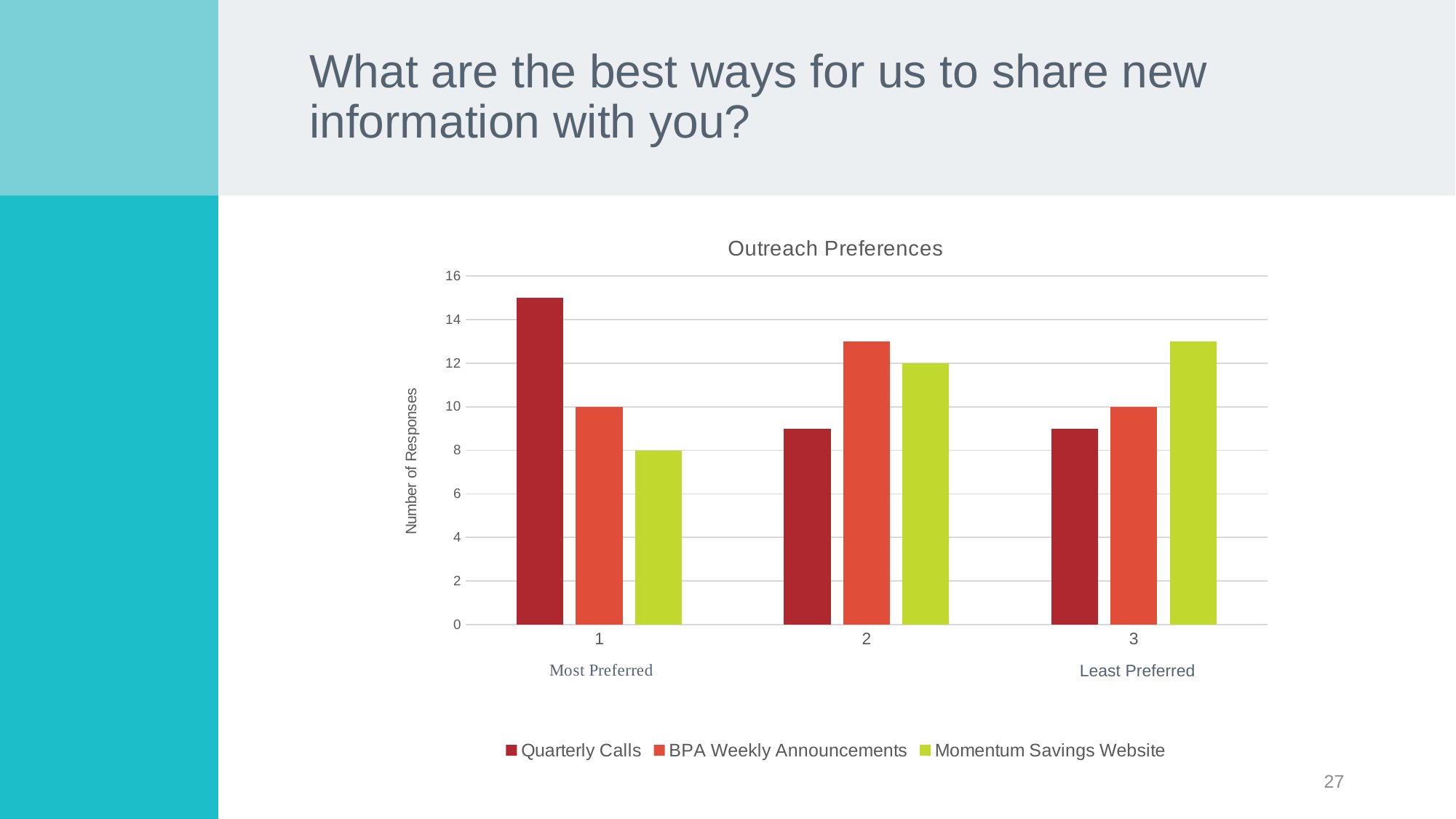
How many series does the legend list? 3 What is the title of the chart? Outreach Preferences What is the value for Momentum Savings Website at category 2? 12 How many categories are shown on the x axis? 3 What is the value for BPA Weekly Announcements at category 3? 10 Which series has the lowest value at category 3? Quarterly Calls What is the value for Momentum Savings Website at category 1? 8 Is the value for Quarterly Calls at category 2 greater or less than 10? less Which series has the highest value at category 1? Quarterly Calls What type of chart is shown on the slide? bar chart What is the value for BPA Weekly Announcements at category 1? 10 Is the value for Quarterly Calls at category 1 greater or less than 14? greater